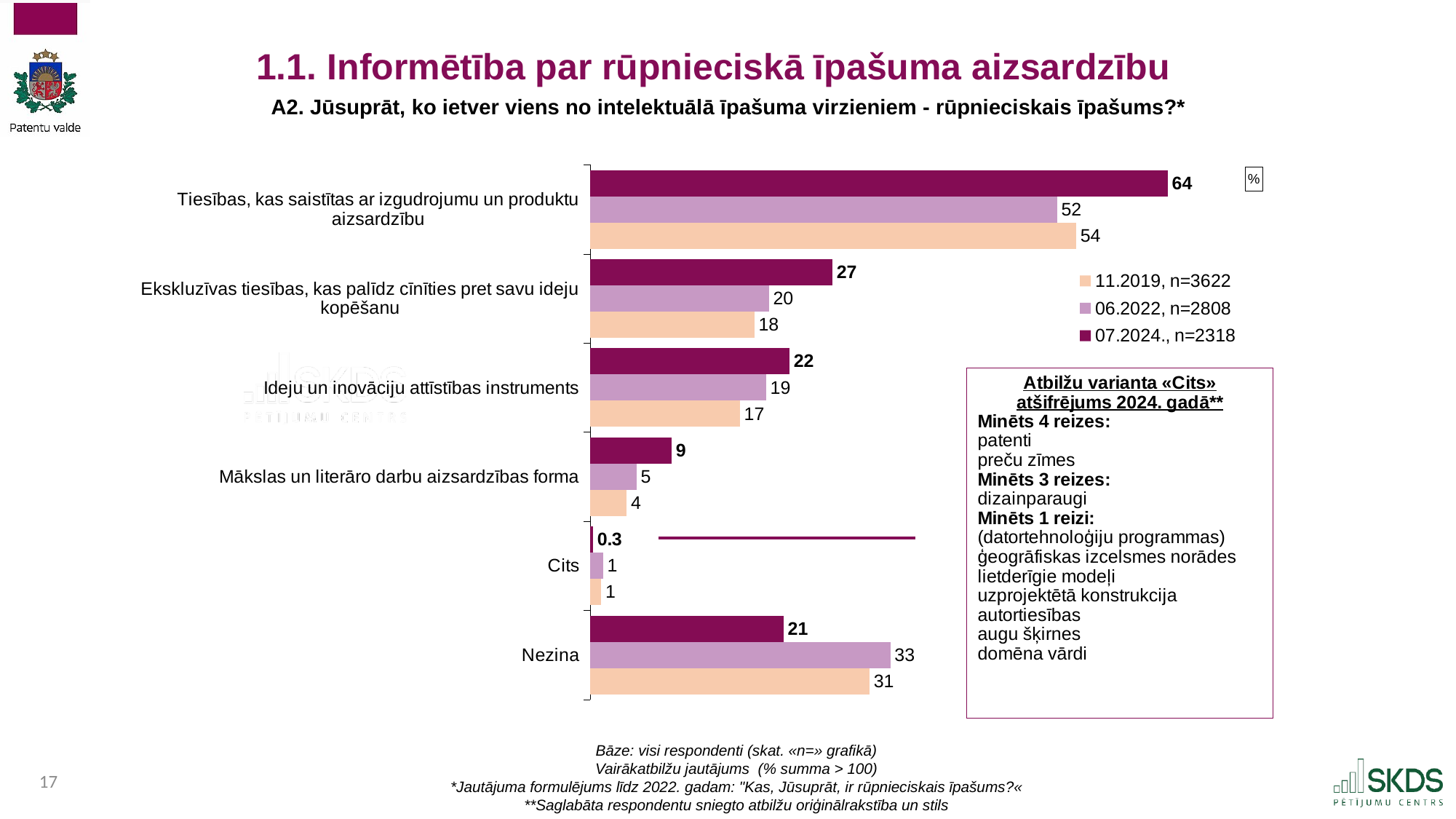
What is the value for "Cits" in the 07.2024 series? 0.3 What is the value for "Tiesības, kas saistītas ar izgudrojumu un produktu aizsardzību" in the 07.2024 series? 64 What is the difference between the 06.2022 and 07.2024 values for "Nezina"? 12 Which category has the lowest value in the 06.2022 series? Cits How many categories are shown on the chart? 6 What is the value for "Nezina" in the 06.2022 series? 33 How many series does the legend list? 3 What kind of chart is shown on the slide? Bar chart What is the difference between the 07.2024 and 06.2022 values for "Tiesības, kas saistītas ar izgudrojumu un produktu aizsardzību"? 12 Which category has the highest value in the 07.2024 series? Tiesības, kas saistītas ar izgudrojumu un produktu aizsardzību What is the value for "Ekskluzīvas tiesības, kas palīdz cīnīties pret savu ideju kopēšanu" in the 11.2019 series? 18 Which is larger for "Ideju un inovāciju attīstības instruments": the 07.2024 value or the 11.2019 value? 07.2024